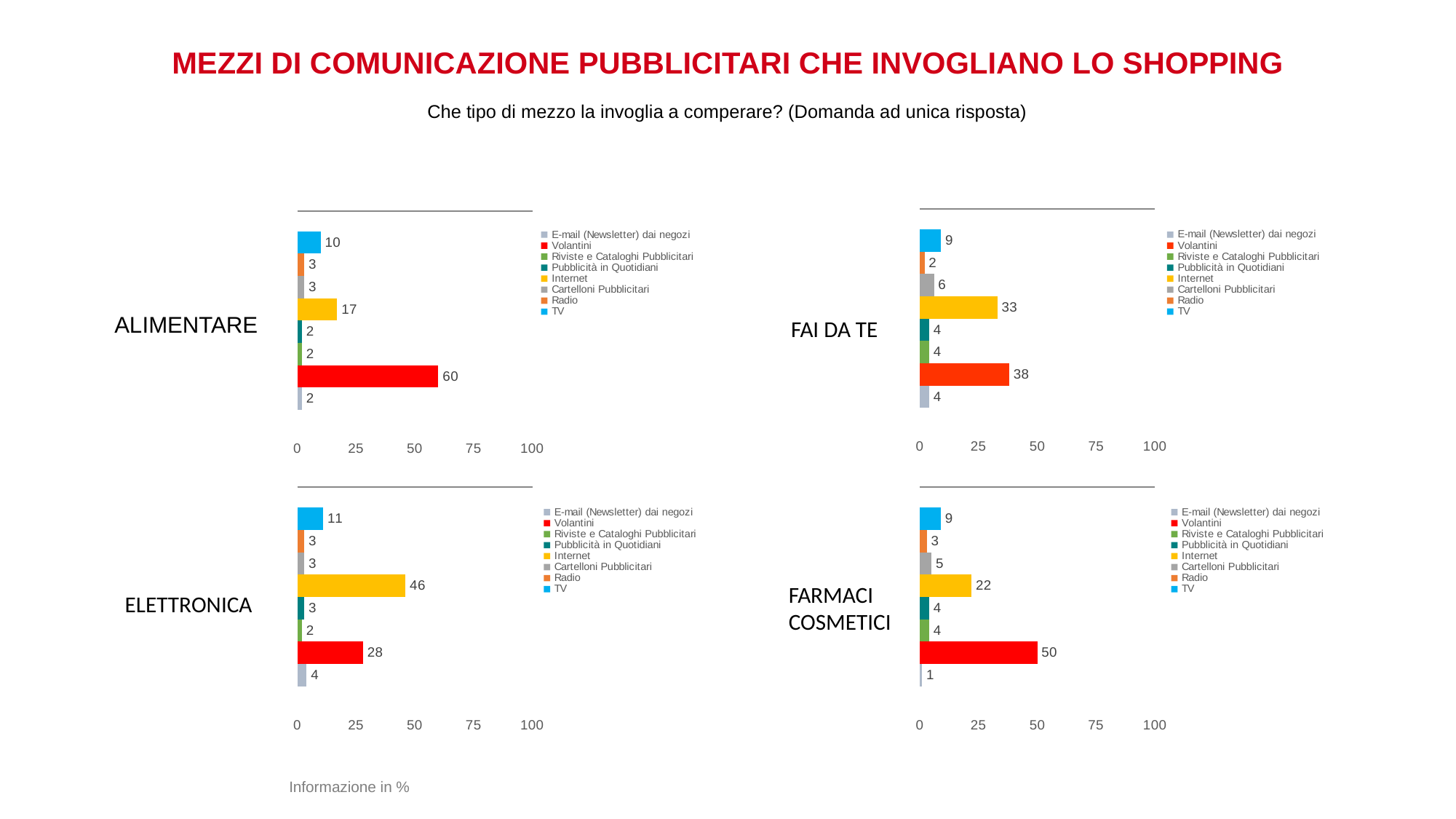
In the FAI DA TE chart, what is the difference between Volantini and Internet? 5 In the ALIMENTARE chart, what is the value for Volantini? 60 In the ELETTRONICA chart, is the value for Volantini greater or less than 25? greater In the FARMACI COSMETICI chart, which medium has the lowest value? E-mail (Newsletter) dai negozi In the FAI DA TE chart, what is the value for Internet? 33 What kind of chart is the ALIMENTARE chart? Bar chart In the ELETTRONICA chart, which medium has the highest value? Internet How many series does the legend of the FAI DA TE chart list? 8 In the ELETTRONICA chart, what is the value for TV? 11 In the FARMACI COSMETICI chart, what is the difference between Volantini and Internet? 28 In the ALIMENTARE chart, which is larger, Internet or TV? Internet In the FARMACI COSMETICI chart, what is the value for E-mail (Newsletter) dai negozi? 1